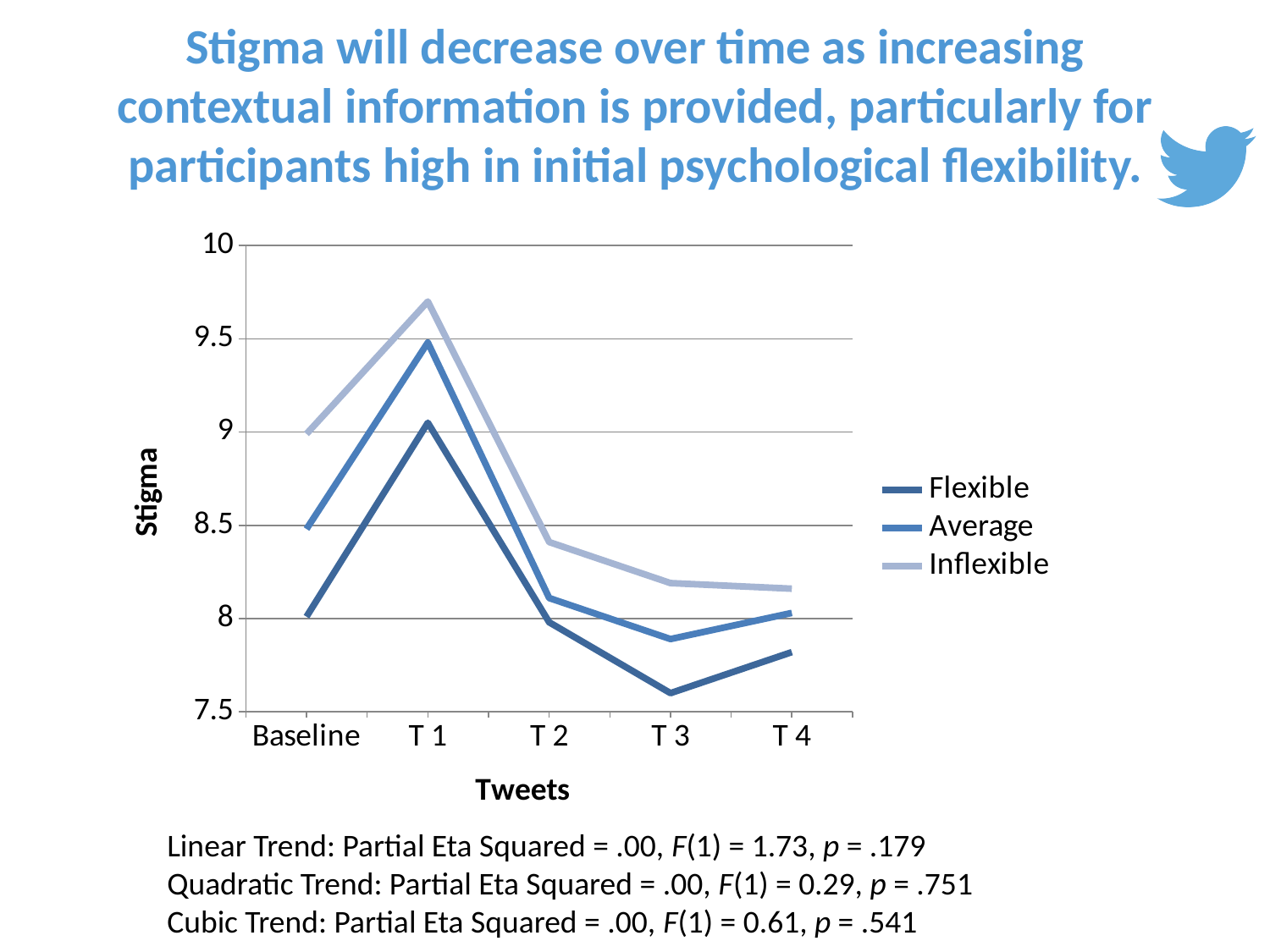
Is the value for Inflexible at T 4 greater or less than 8? greater How many time points are plotted along the x axis? 5 What is the label on the vertical axis of the chart? Stigma How many series does the chart legend list? 3 Is the value for Average at T 1 greater or less than 9? greater Is the value for Flexible at T 3 greater or less than 8? less What kind of chart is shown on the slide? line chart Do the values of the Average series rise or fall from T 1 to T 3? fall At T 2, which series has the larger value, Inflexible or Flexible? Inflexible At which time point does the Flexible series reach its lowest value? T 3 At which time point does the Inflexible series reach its highest value? T 1